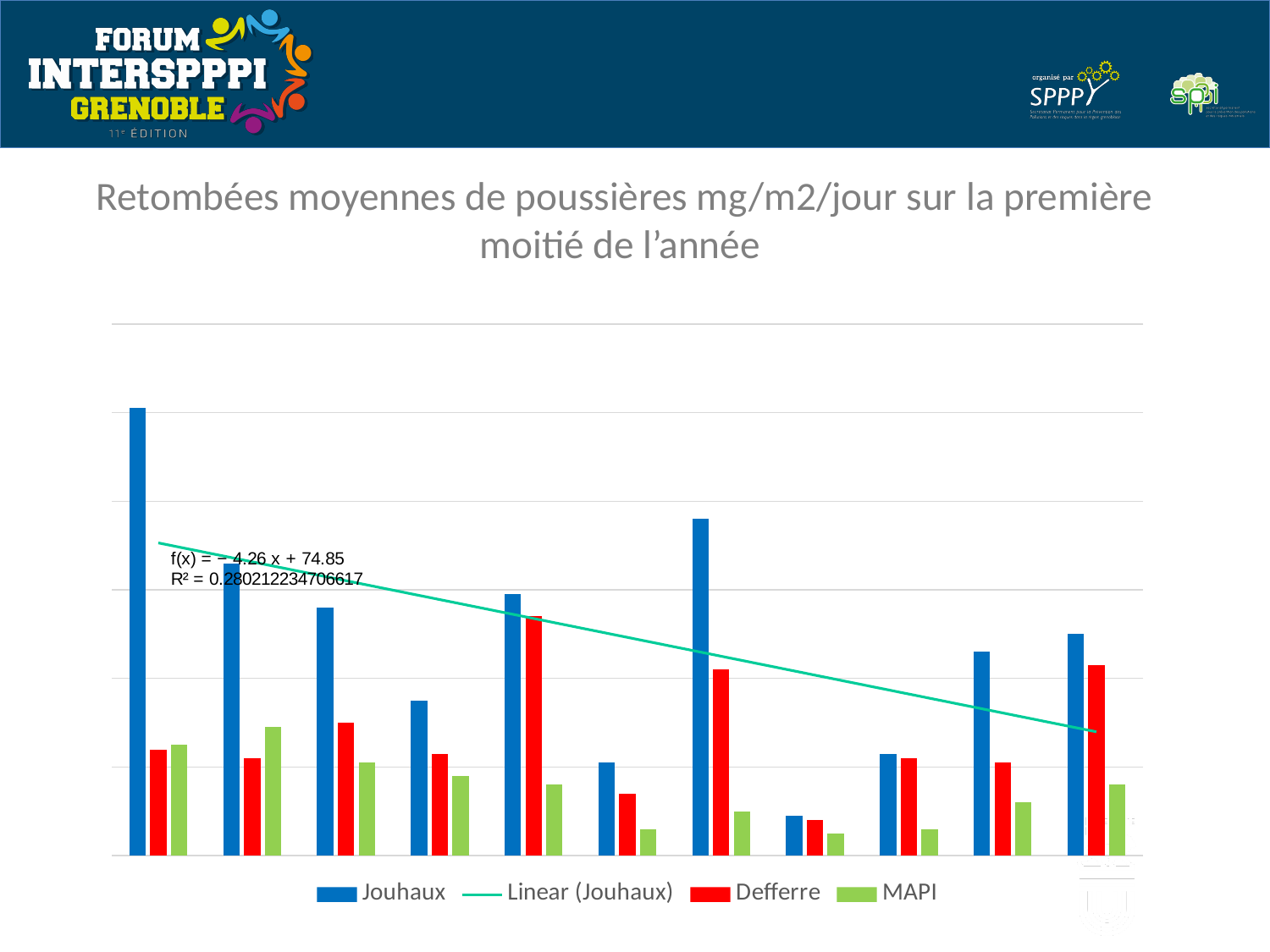
What R² value is printed for the linear trendline? 0.280212234706617 What kind of chart is shown on the slide? bar chart In the leftmost group of bars, which series has the tallest bar? Jouhaux What is the title of the chart? Retombées moyennes de poussières mg/m2/jour sur la première moitié de l'année In the leftmost group of bars, is the Jouhaux bar or the Defferre bar taller? Jouhaux Which series has the tallest bar anywhere on the chart? Jouhaux In the rightmost group of bars, is the Defferre bar or the MAPI bar taller? Defferre What is the equation of the linear trendline shown on the chart? f(x) = − 4.26 x + 74.85 How many groups of bars are plotted along the x axis? 11 Which series is drawn in red? Defferre How many entries does the chart legend list? 4 Does the linear trendline for Jouhaux rise or fall from left to right? fall